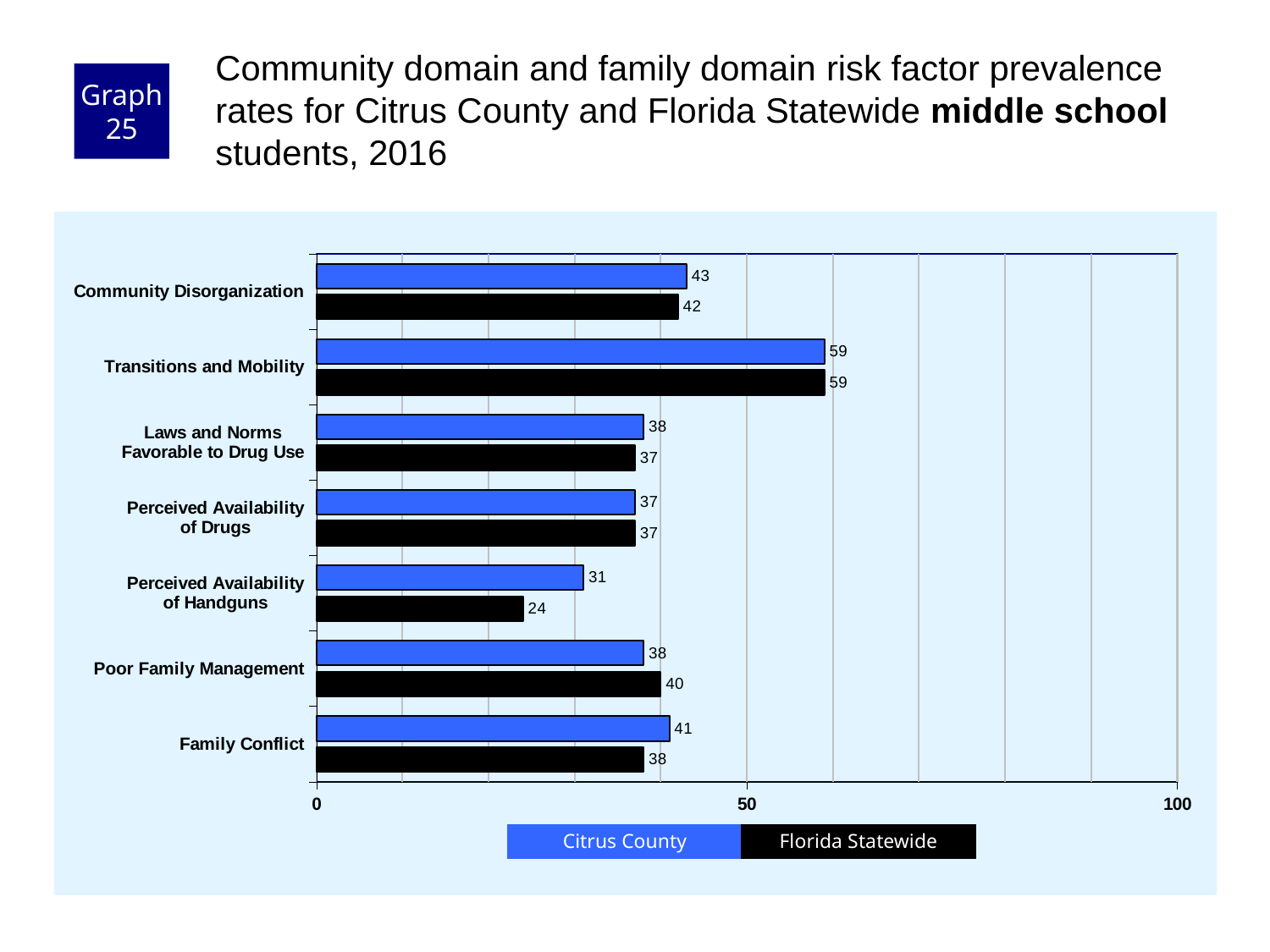
Is the Citrus County value for Transitions and Mobility greater or less than 50? greater What is the difference between the Citrus County and Florida Statewide values for Perceived Availability of Handguns? 7 What is the Florida Statewide value for Perceived Availability of Handguns? 24 Which colour represents Florida Statewide in the chart? black What is the Florida Statewide value for Poor Family Management? 40 Which risk factor has the lowest Florida Statewide value? Perceived Availability of Handguns What kind of chart is shown on the slide? bar chart How many risk factor categories are shown on the chart? 7 Which risk factor has the highest Citrus County value? Transitions and Mobility How many series does the legend list? 2 What is the Citrus County value for Community Disorganization? 43 For Family Conflict, which is larger: the Citrus County value or the Florida Statewide value? Citrus County